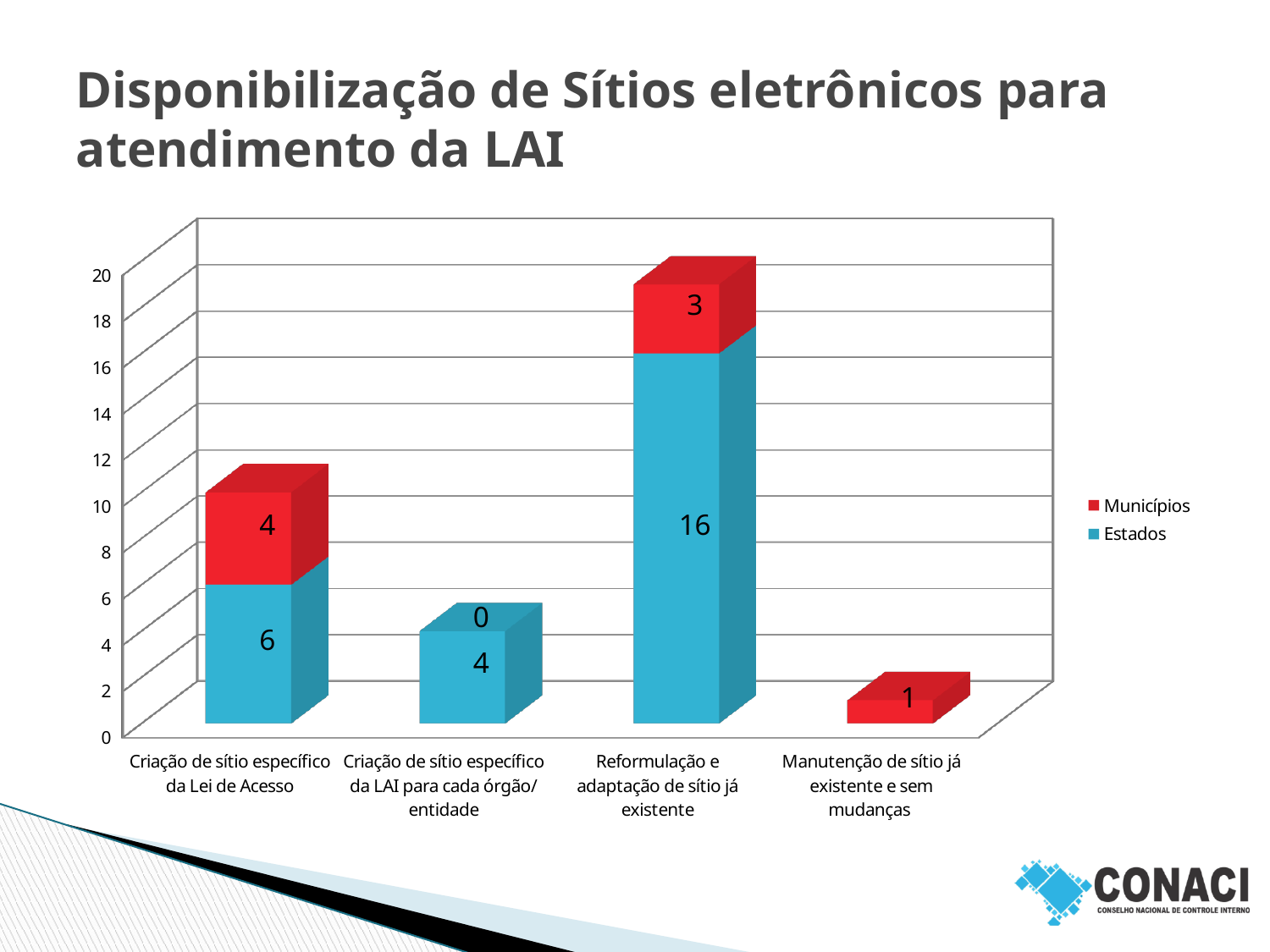
What is the total of the stacked bar for 'Criação de sítio específico da Lei de Acesso'? 10 How many series does the legend list? 2 Which category has the highest value for Estados? Reformulação e adaptação de sítio já existente What is the value for Municípios in the 'Criação de sítio específico da LAI para cada órgão/entidade' category? 0 What is the value for Municípios in the 'Manutenção de sítio já existente e sem mudanças' category? 1 Which category has the lowest value for Municípios? Criação de sítio específico da LAI para cada órgão/entidade What is the total of the stacked bar for 'Reformulação e adaptação de sítio já existente'? 19 How many categories are shown on the x axis? 4 What is the value for Municípios in the 'Criação de sítio específico da Lei de Acesso' category? 4 What is the value for Estados in the 'Reformulação e adaptação de sítio já existente' category? 16 Which is larger: the Municípios value for 'Criação de sítio específico da Lei de Acesso' or for 'Reformulação e adaptação de sítio já existente'? Criação de sítio específico da Lei de Acesso What is the difference between the Estados values for 'Reformulação e adaptação de sítio já existente' and 'Criação de sítio específico da Lei de Acesso'? 10